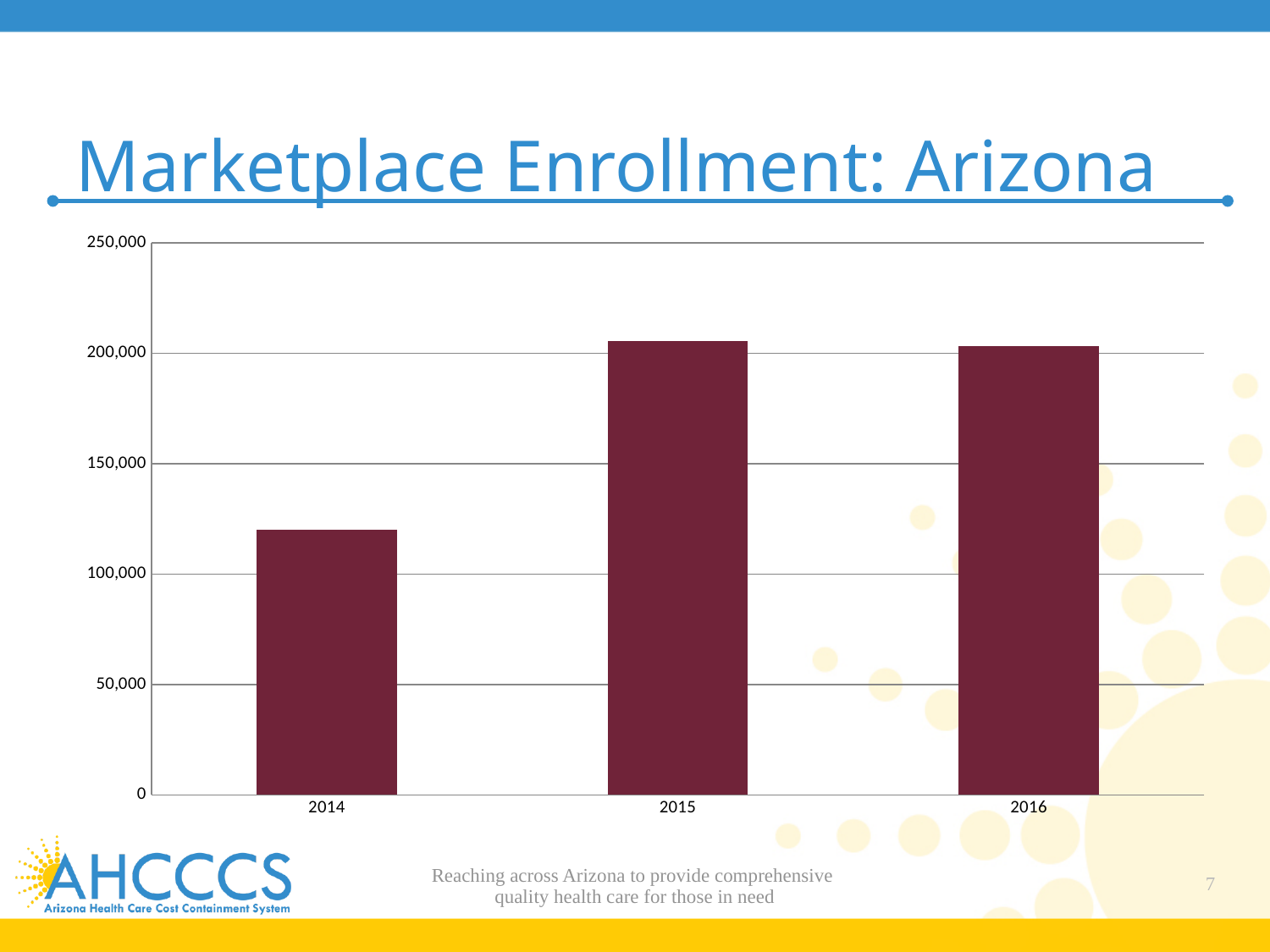
What is the title of the chart? Marketplace Enrollment: Arizona Which year has the lowest enrollment in the chart? 2014 Is the value for 2014 greater or less than 150,000? less How many years are shown on the x axis of the chart? 3 Which is larger, the value for 2014 or the value for 2015? 2015 Is the value for 2015 greater or less than 200,000? greater Which is larger, the value for 2014 or the value for 2016? 2016 Is the value for 2016 greater or less than 150,000? greater What kind of chart is shown on the slide? bar chart What is the highest value shown on the y axis of the chart? 250,000